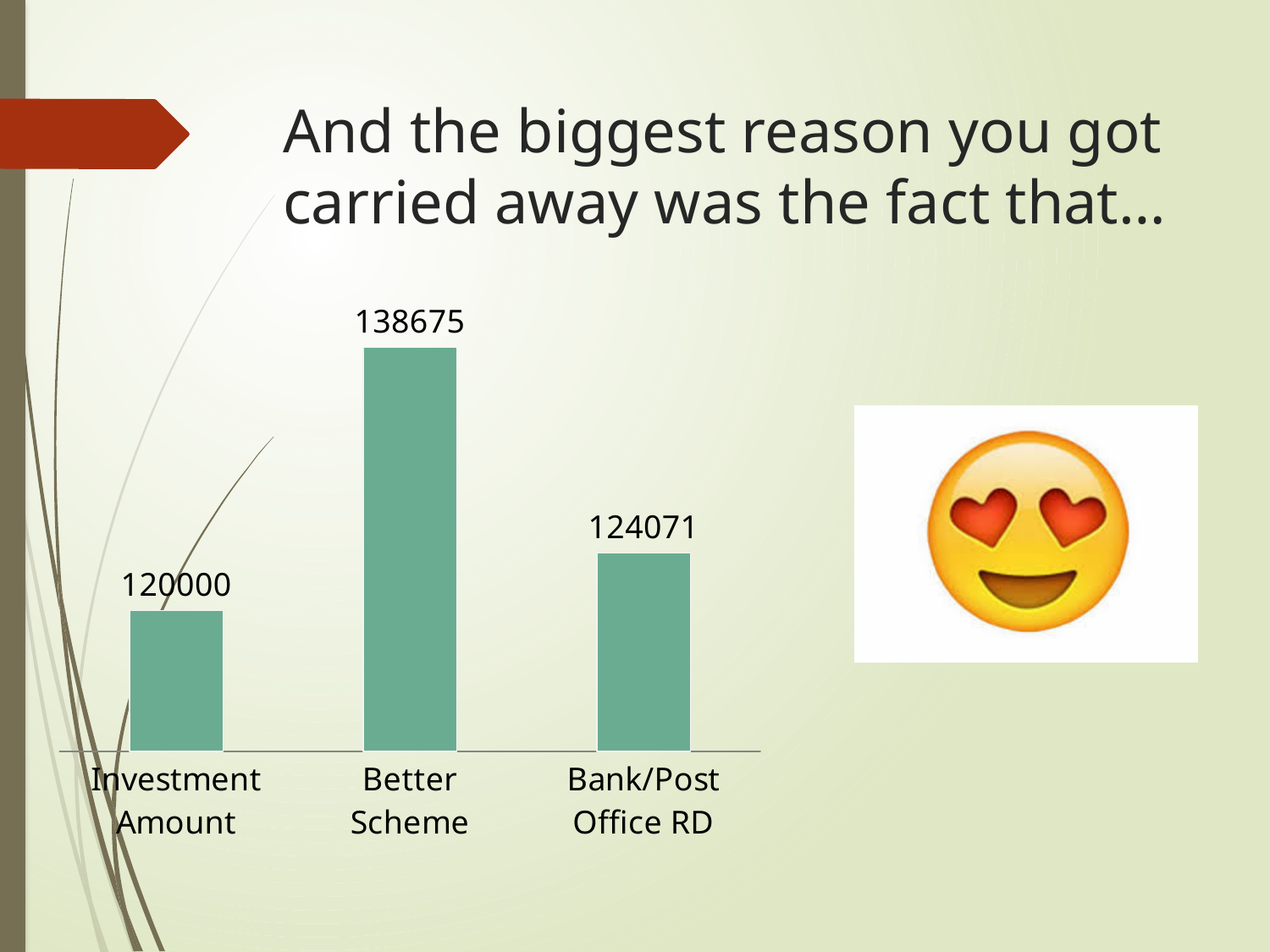
What is the difference between the values for Bank/Post Office RD and Investment Amount? 4071 What is the difference between the values for Better Scheme and Bank/Post Office RD? 14604 Which is larger, the value for Better Scheme or the value for Bank/Post Office RD? Better Scheme What colour are the bars in the chart? Green What is the difference between the values for Better Scheme and Investment Amount? 18675 What is the value for Bank/Post Office RD? 124071 Which category has the lowest value? Investment Amount What is the value for Better Scheme? 138675 What is the value for Investment Amount? 120000 Which category has the highest value? Better Scheme How many categories are shown in the chart? 3 What kind of chart is shown on the slide? Bar chart